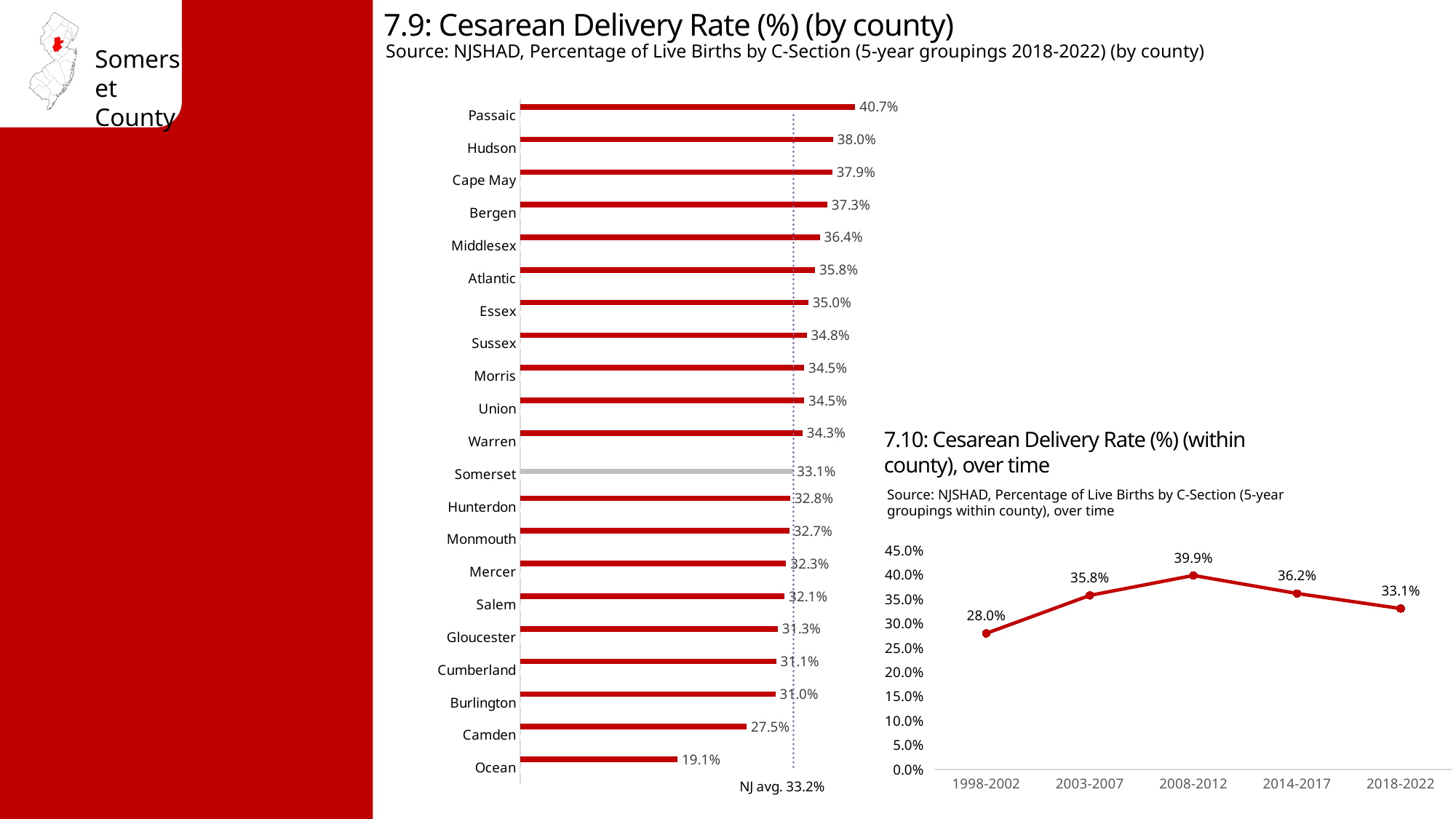
In the 7.10 chart (within county, over time), what is the cesarean delivery rate for 2008-2012? 39.9% In the 7.10 chart (within county, over time), what is the difference between the 2008-2012 and 2018-2022 rates? 6.8% In the 7.9 chart (by county), which county has the highest cesarean delivery rate? Passaic In the 7.9 chart (by county), which has a higher cesarean delivery rate, Hudson or Camden? Hudson In the 7.10 chart (within county, over time), how many time periods are plotted? 5 In the 7.9 chart (by county), what is the NJ average shown by the dotted line? 33.2% In the 7.9 chart (by county), which county has the lowest cesarean delivery rate? Ocean In the 7.10 chart (within county, over time), which period has the lowest rate? 1998-2002 In the 7.9 chart (by county), what is the difference between the rates for Passaic and Ocean? 21.6% What kind of chart is the 7.10 chart (within county, over time)? line chart In the 7.9 chart (by county), what is the cesarean delivery rate for Somerset? 33.1% In the 7.9 chart (by county), how many counties are shown? 21